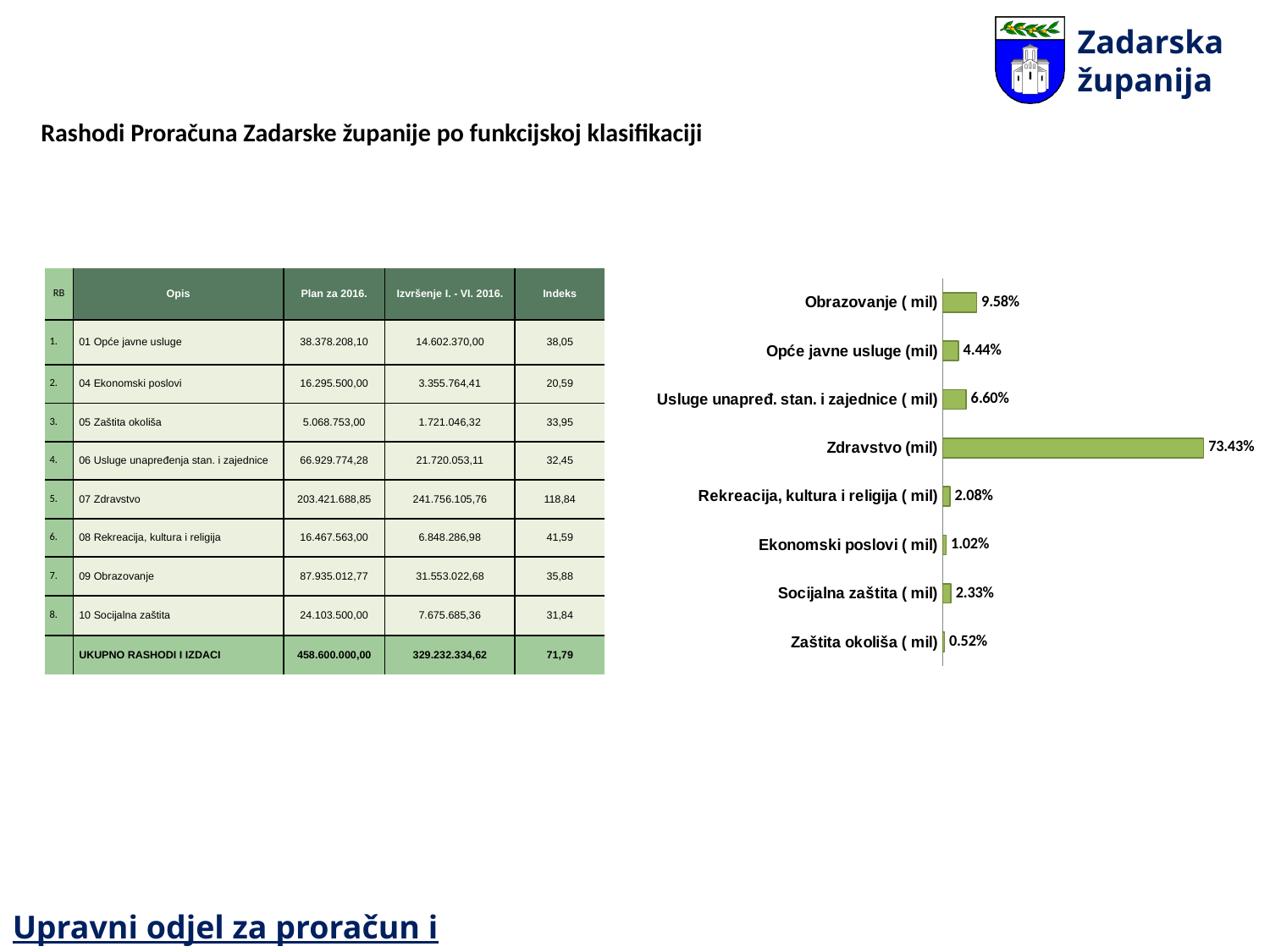
What value is shown for Usluge unapređ. stan. i zajednice (mil) in the bar chart? 6.60% Which category has the lowest value in the bar chart? Zaštita okoliša (mil) What value is shown for Zdravstvo (mil) in the bar chart? 73.43% Which category has the highest value in the bar chart? Zdravstvo (mil) What value is shown for Socijalna zaštita (mil) in the bar chart? 2.33% What is the difference between the values for Zdravstvo (mil) and Obrazovanje (mil) in the bar chart? 63.85% In the bar chart, which is larger: Socijalna zaštita (mil) or Rekreacija, kultura i religija (mil)? Socijalna zaštita (mil) In the bar chart, which is larger: Ekonomski poslovi (mil) or Opće javne usluge (mil)? Opće javne usluge (mil) What is the difference between the values for Obrazovanje (mil) and Opće javne usluge (mil) in the bar chart? 5.14% What type of chart is shown on the slide? Bar chart How many categories are shown in the bar chart? 8 What value is shown for Obrazovanje (mil) in the bar chart? 9.58%